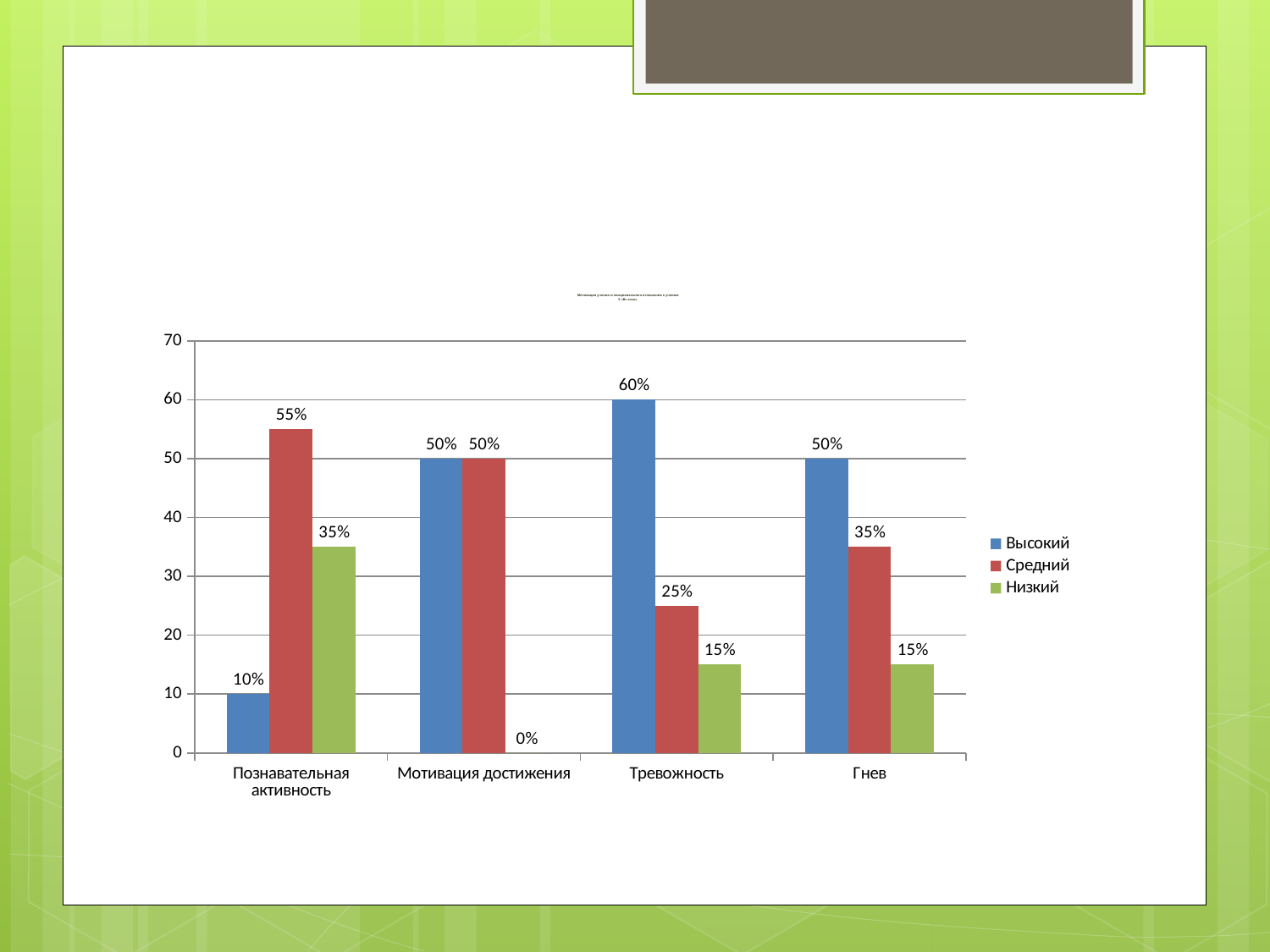
Which is larger in the Гнев category: the Высокий value or the Низкий value? Высокий Which category has the lowest value for the Высокий series? Познавательная активность What is the value for Низкий in the Мотивация достижения category? 0% What is the value for Высокий in the Тревожность category? 60% How many categories are shown on the x axis? 4 What colour represents the Средний series in the legend? Red What is the difference between the Средний and Высокий values in the Познавательная активность category? 45% How many series does the legend list? 3 What is the value for Низкий in the Познавательная активность category? 35% What kind of chart is shown on the slide? Bar chart What is the value for Средний in the Гнев category? 35% Which category has the highest value for the Высокий series? Тревожность